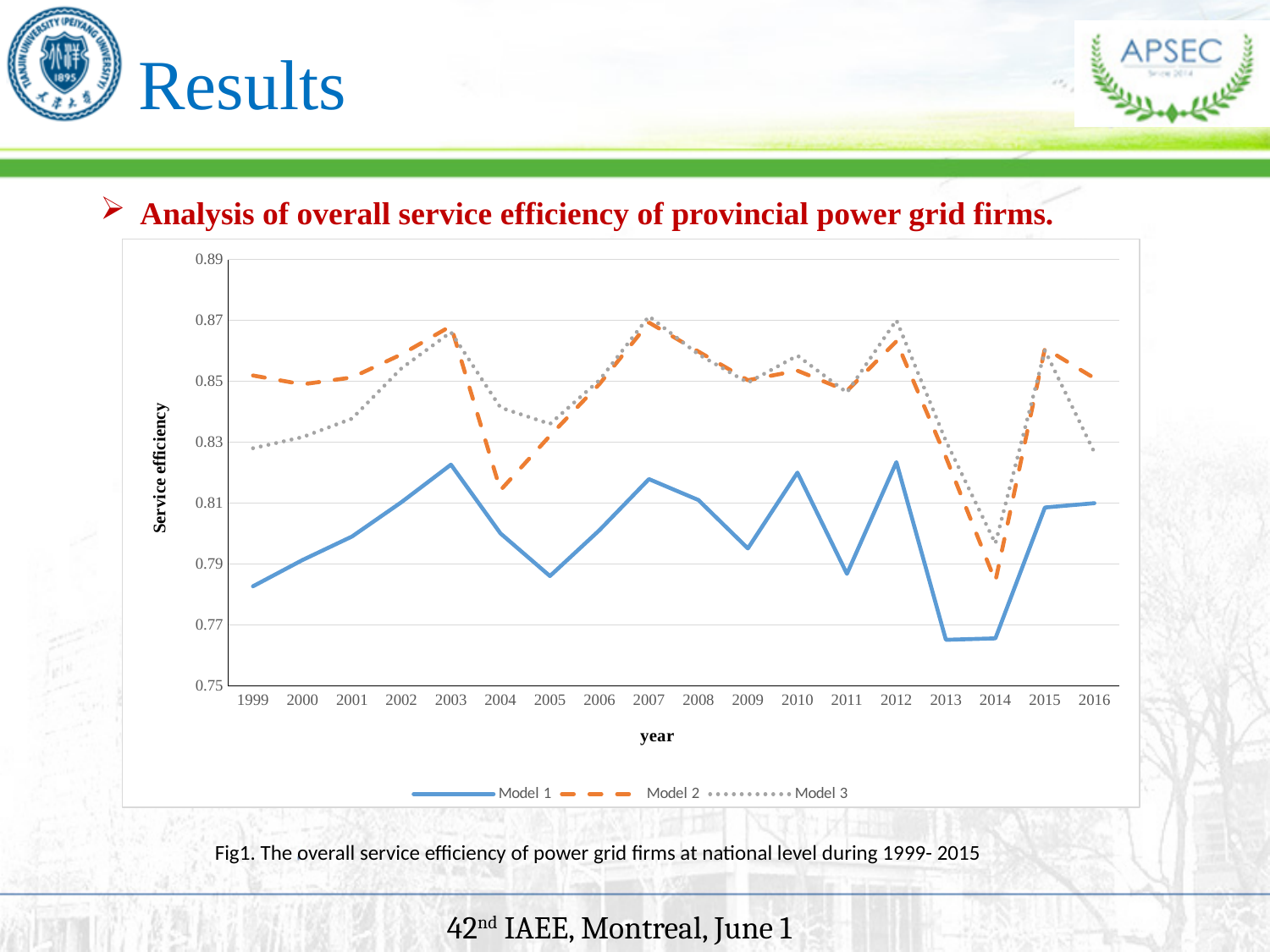
How many series does the legend list? 3 Is the value for Model 1 in 2013 greater or less than 0.77? less Is the value for Model 1 in 1999 greater or less than 0.79? less What is the label on the vertical axis? Service efficiency Is the value for Model 3 in 2005 greater or less than 0.85? less In which year does Model 2 reach its lowest value? 2014 Does Model 1 rise or fall from 2012 to 2013? fall In 1999, which is larger, Model 2 or Model 3? Model 2 How many years are plotted along the x axis? 18 What type of chart is shown on the slide? line chart In 2014, which is larger, Model 1 or Model 2? Model 2